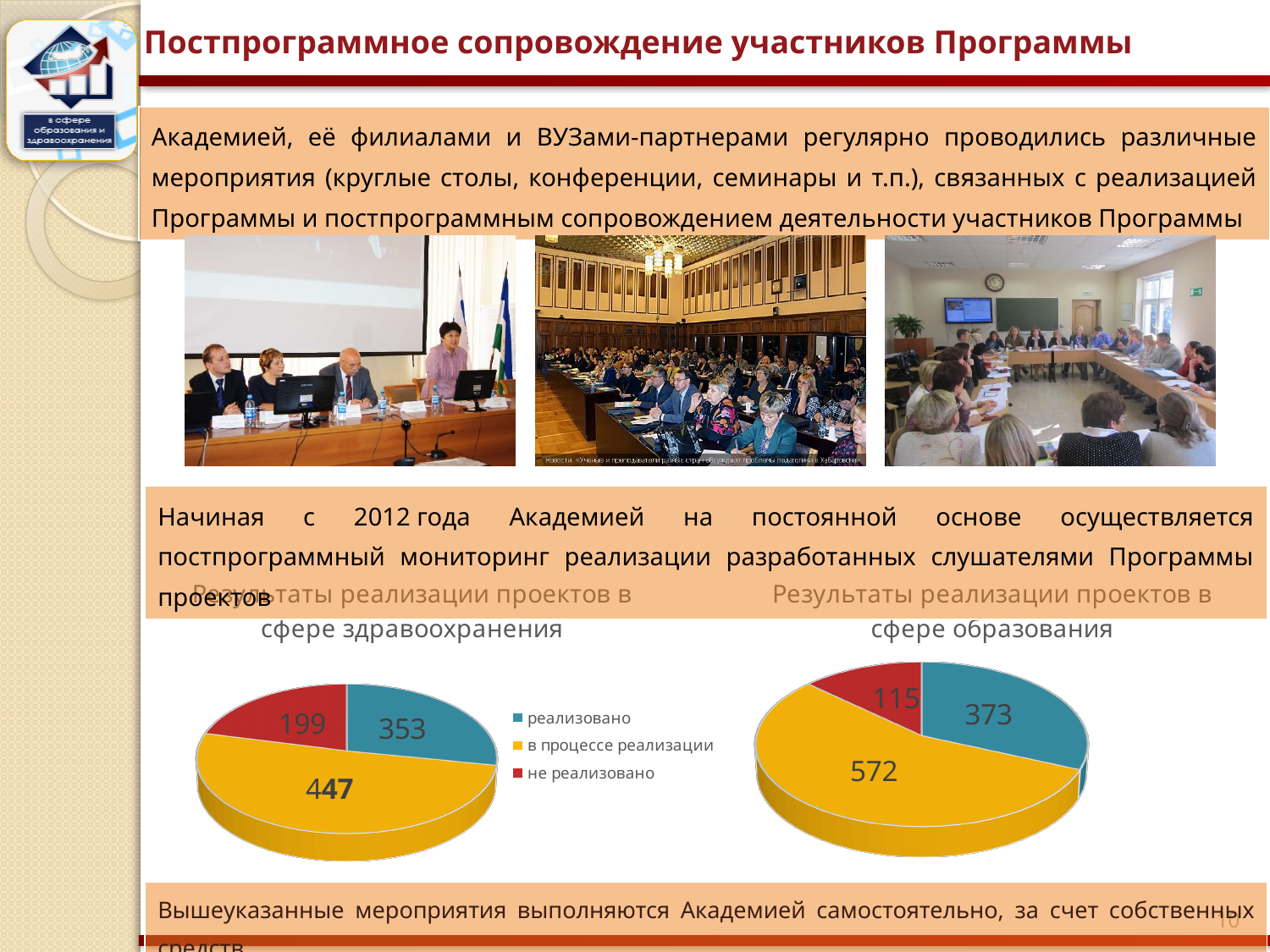
In the chart 'Результаты реализации проектов в сфере образования', what is the value for 'не реализовано'? 115 In the chart 'Результаты реализации проектов в сфере образования', which category has the smallest value? не реализовано In the chart 'Результаты реализации проектов в сфере здравоохранения', which category has the largest value? в процессе реализации In the chart 'Результаты реализации проектов в сфере здравоохранения', what is the value for 'в процессе реализации'? 447 What is the total of all slices in the chart 'Результаты реализации проектов в сфере образования'? 1060 How many categories does the chart 'Результаты реализации проектов в сфере здравоохранения' show? 3 Which is larger: 'реализовано' in the chart 'Результаты реализации проектов в сфере здравоохранения' or 'реализовано' in the chart 'Результаты реализации проектов в сфере образования'? сфере образования (373) In the chart 'Результаты реализации проектов в сфере образования', what is the difference between 'реализовано' and 'не реализовано'? 258 In the chart 'Результаты реализации проектов в сфере образования', what is the value for 'в процессе реализации'? 572 In the chart 'Результаты реализации проектов в сфере здравоохранения', what is the difference between 'в процессе реализации' and 'реализовано'? 94 What type of chart is 'Результаты реализации проектов в сфере образования'? pie chart In the chart 'Результаты реализации проектов в сфере здравоохранения', what is the value for 'реализовано'? 353